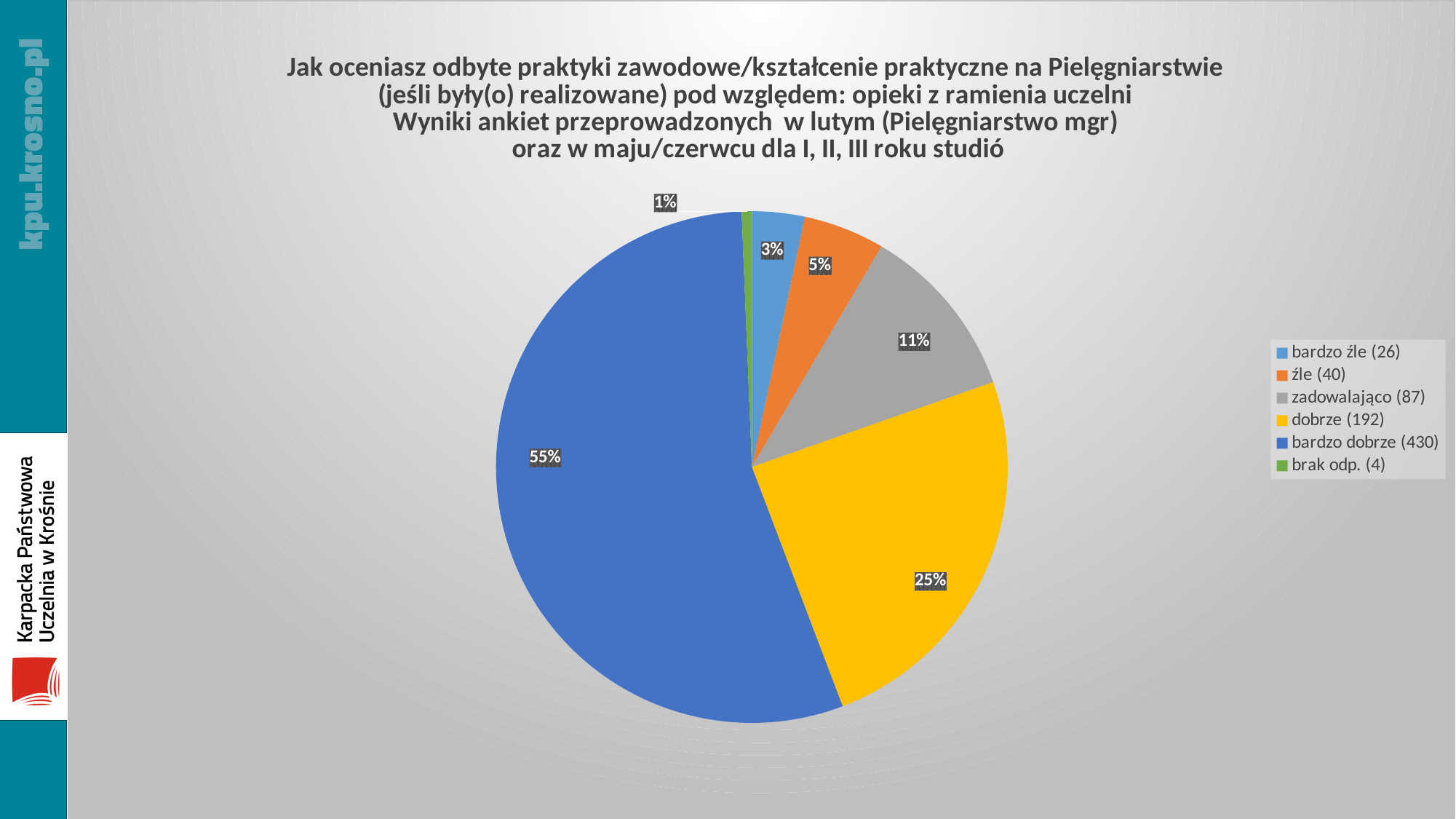
How many entries does the legend list? 6 What is the difference in percentage points between the 'bardzo dobrze (430)' slice and the 'dobrze (192)' slice? 30 How many slices does the pie chart have? 6 Which category has the largest slice of the pie? bardzo dobrze (430) What percentage share does the 'zadowalająco (87)' slice have? 11% What percentage share does the 'bardzo dobrze (430)' slice have? 55% What percentage share does the 'bardzo źle (26)' slice have? 3% What kind of chart is shown on the slide? pie chart Which category has the smallest slice of the pie? brak odp. (4) Which slice is larger: 'zadowalająco (87)' or 'źle (40)'? zadowalająco (87)